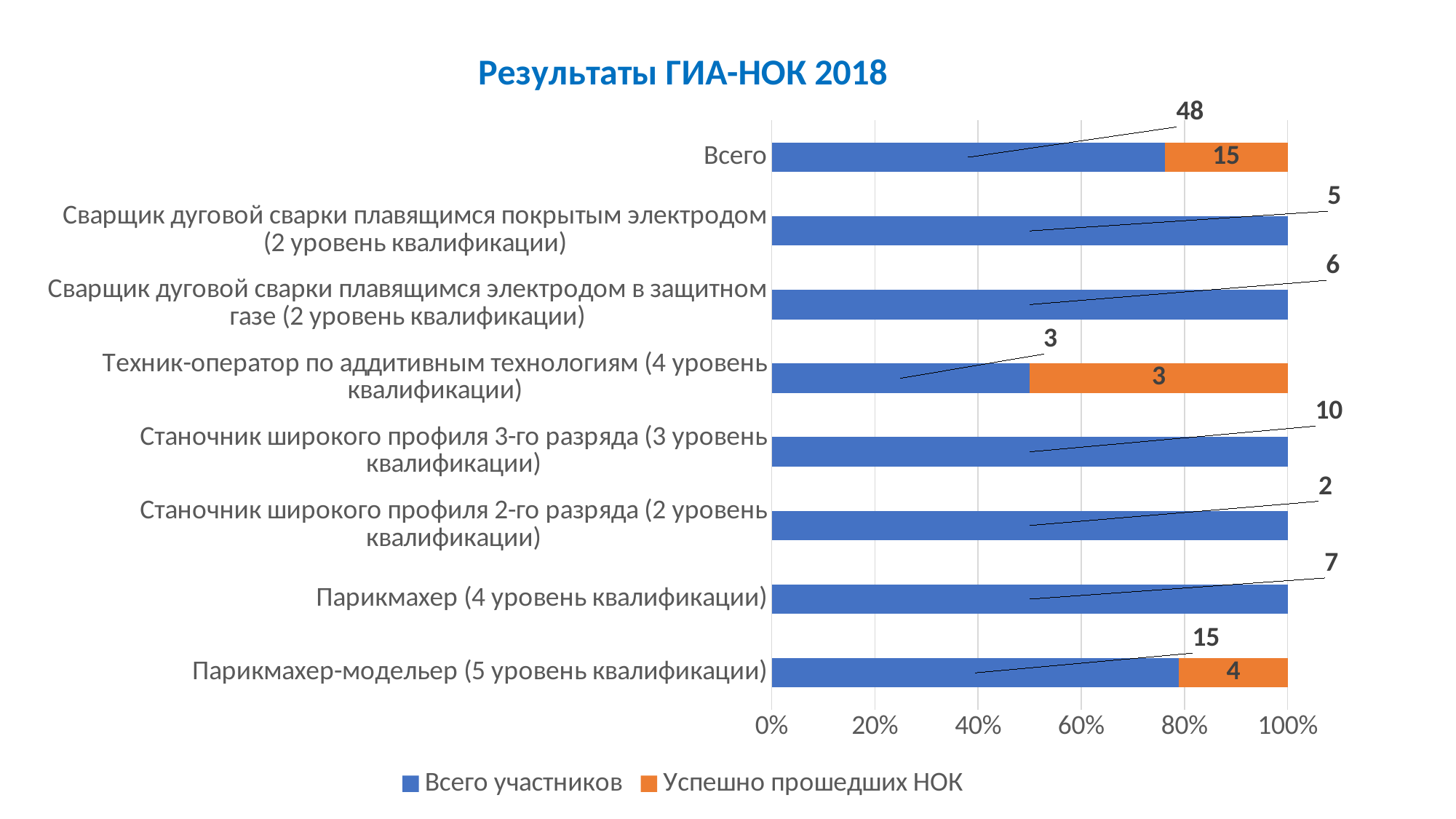
What is the value of 'Всего участников' for the 'Всего' category? 48 What is the title of the chart? Результаты ГИА-НОК 2018 What is the difference between the 'Всего участников' values for 'Парикмахер (4 уровень квалификации)' and 'Станочник широкого профиля 2-го разряда (2 уровень квалификации)'? 5 What is the value of 'Всего участников' for 'Парикмахер-модельер (5 уровень квалификации)'? 15 How many series does the legend list? 2 How many categories are shown on the vertical axis of the chart? 8 What is the value of 'Успешно прошедших НОК' for the 'Всего' category? 15 What kind of chart is shown on the slide? bar chart What is the value of 'Успешно прошедших НОК' for 'Техник-оператор по аддитивным технологиям (4 уровень квалификации)'? 3 What is the value of 'Всего участников' for 'Станочник широкого профиля 3-го разряда (3 уровень квалификации)'? 10 Which is larger: the 'Всего участников' value for 'Сварщик дуговой сварки плавящимся электродом в защитном газе (2 уровень квалификации)' or for 'Сварщик дуговой сварки плавящимся покрытым электродом (2 уровень квалификации)'? Сварщик дуговой сварки плавящимся электродом в защитном газе (2 уровень квалификации) Which category has the lowest 'Всего участников' value? Станочник широкого профиля 2-го разряда (2 уровень квалификации)